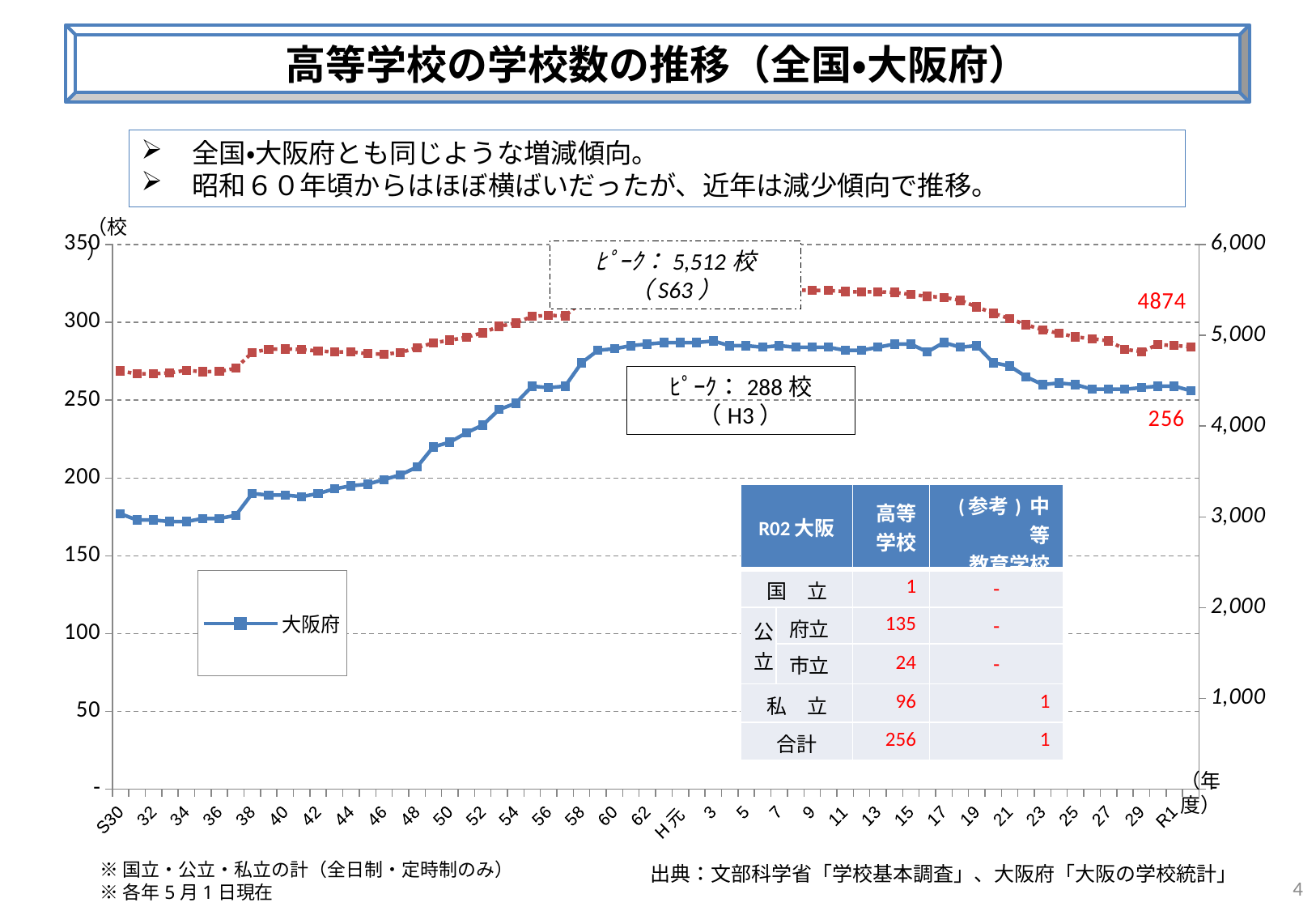
According to the annotation, in which year did the 大阪府 line reach its peak? H3 Which is larger for the 大阪府 line: the value at S30 or the value at R1? R1 How much lower is the final 全国 value (4874) than its peak (5,512)? 638 According to the annotation, what is the peak value of the 全国 (red) line and in which year? 5,512 校 (S63) Does the 大阪府 line rise or fall between H19 and R1? fall How many series does the legend list? 1 What is the value printed at the right end of the 大阪府 (blue) line? 256 How much lower is the final 大阪府 value (256) than its peak (288)? 32 What is the value printed at the right end of the red (全国) line? 4874 According to the annotation, what is the peak value of the 大阪府 line? 288 校 Is the 大阪府 value at S30 greater or less than 200? less What kind of chart is shown on the slide? line chart